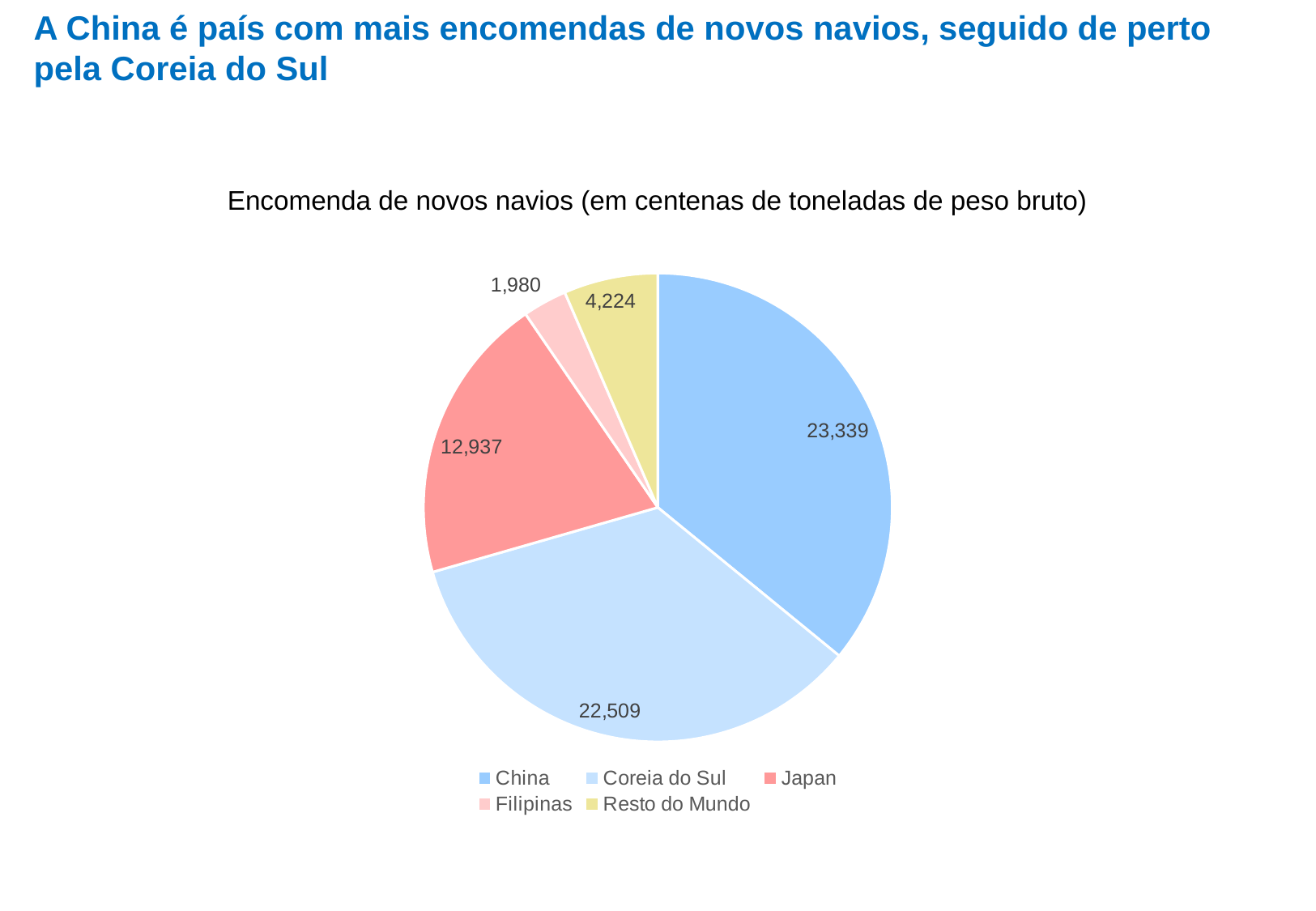
Which category has the smallest slice of the pie chart? Filipinas How many categories does the pie chart show? 5 Which category has the largest slice of the pie chart? China Which is larger, the value for China or the value for Coreia do Sul? China What is the difference between the values for China and Coreia do Sul? 830 What is the title of the chart? Encomenda de novos navios (em centenas de toneladas de peso bruto) What is the value for Japan in the pie chart? 12,937 What is the value for Filipinas in the pie chart? 1,980 What is the value for China in the pie chart? 23,339 What is the value for Resto do Mundo in the pie chart? 4,224 What kind of chart is shown on the slide? Pie chart What is the difference between the values for Japan and Resto do Mundo? 8,713